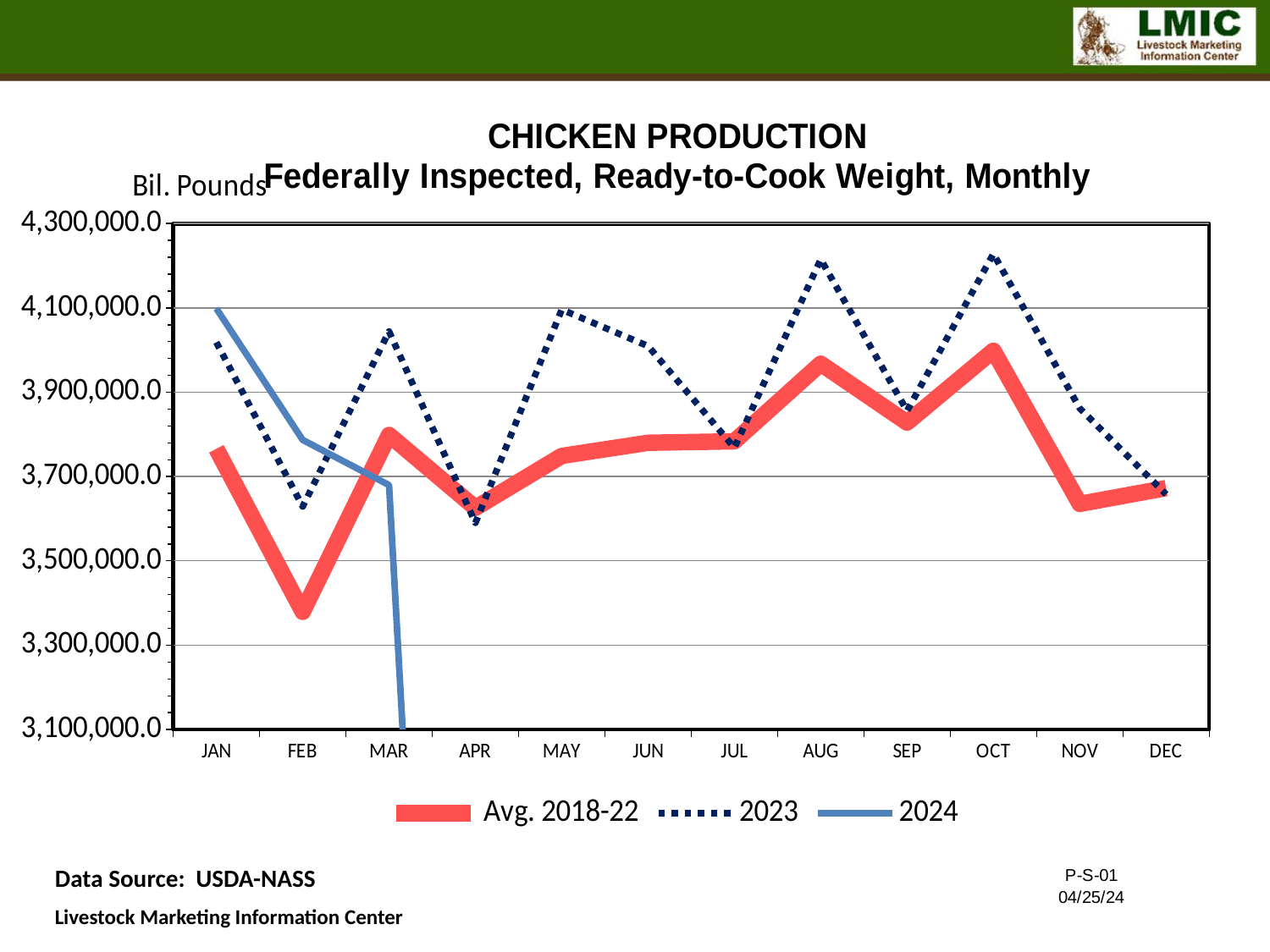
What is the title of the chart? CHICKEN PRODUCTION Federally Inspected, Ready-to-Cook Weight, Monthly In JAN, which series has the higher value, 2024 or Avg. 2018-22? 2024 Is the 2023 value for OCT greater or less than 4,100,000.0? greater Is the 2023 value for APR greater or less than 3,700,000.0? less What kind of chart is shown on the slide? line chart How many series does the legend list? 3 Is the Avg. 2018-22 value for FEB greater or less than 3,500,000.0? less In MAR, which series has the higher value, 2023 or Avg. 2018-22? 2023 In which month is the Avg. 2018-22 series at its lowest? FEB Does the 2024 series rise or fall from JAN to MAR? fall What unit label is shown on the y axis? Bil. Pounds How many months are shown along the x axis? 12